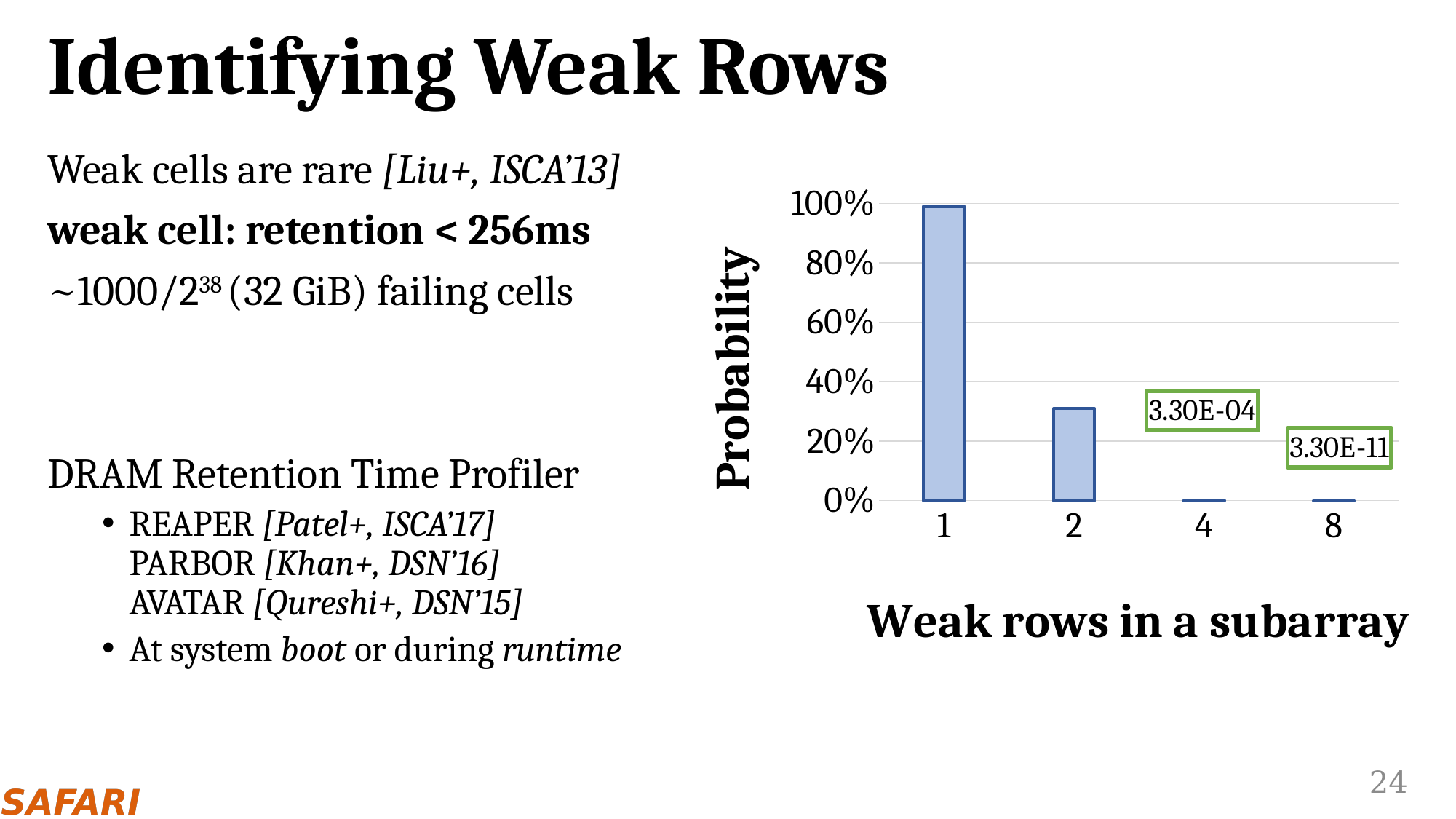
What kind of chart is shown on the slide? bar chart How many categories are shown on the x axis of the chart? 4 Which has a larger probability: 4 weak rows or 8 weak rows in a subarray? 4 Which number of weak rows in a subarray has the lowest probability? 8 Is the probability for 2 weak rows in a subarray greater or less than 40%? less Is the probability for 1 weak row in a subarray greater or less than 80%? greater What is the probability value labelled for 8 weak rows in a subarray? 3.30E-11 What is the title of the x axis of the chart? Weak rows in a subarray What is the probability value labelled for 4 weak rows in a subarray? 3.30E-04 Which number of weak rows in a subarray has the highest probability? 1 What is the title of the y axis of the chart? Probability Do the probability values rise or fall as the number of weak rows in a subarray increases along the x axis? fall